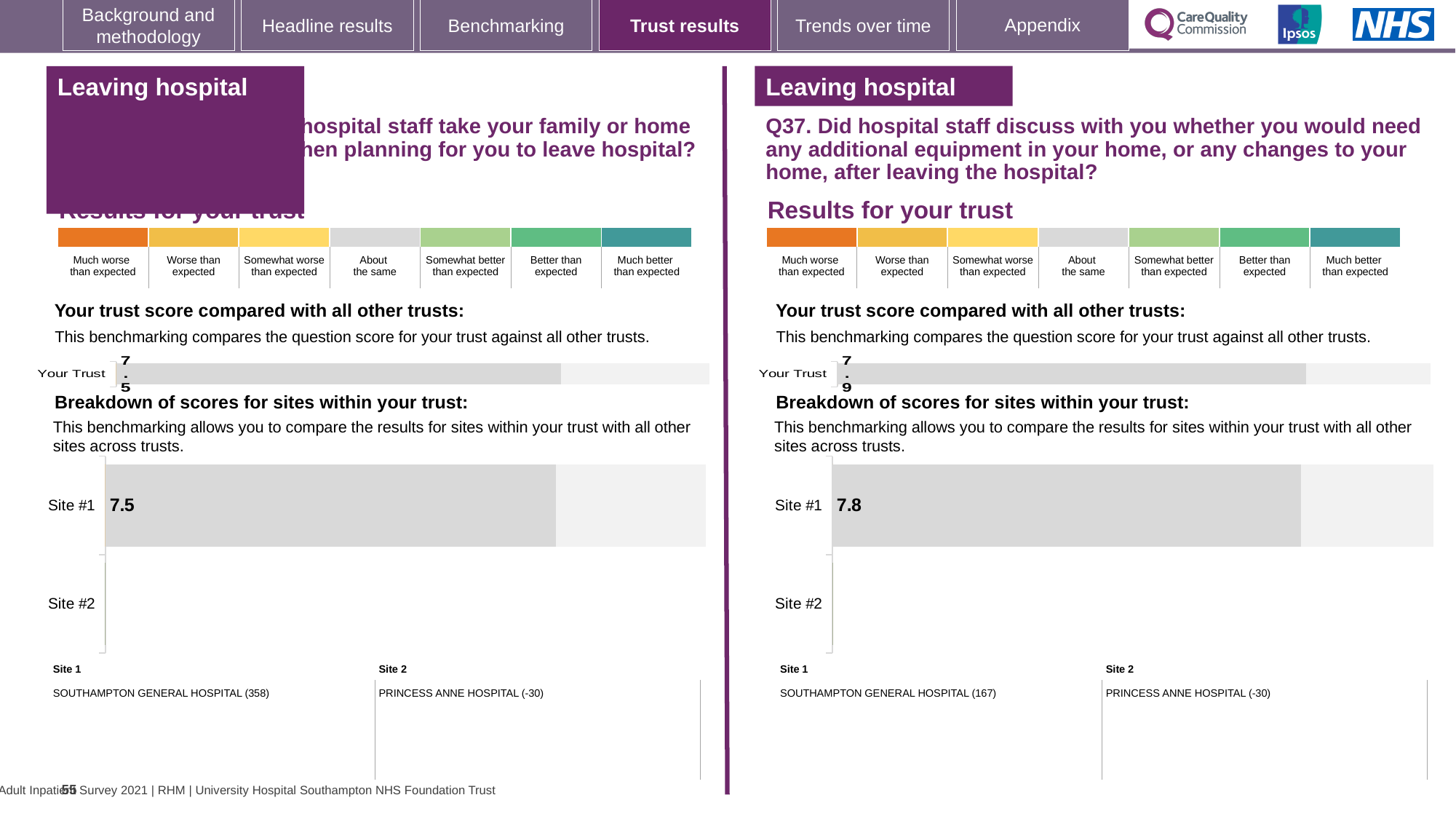
In the left-hand breakdown chart, is the Site #1 score greater or less than the Site #2 score, given Site #2 shows no bar? greater On the right-hand side of the slide (Q37), what is the score shown for Your Trust? 7.9 In the left-hand breakdown of scores for sites chart, what is the score for Site #1? 7.5 What type of chart is used to show the breakdown of scores for sites within your trust? Bar chart Which is larger: the Your Trust score on the left-hand side of the slide or the Your Trust score on the right-hand side (Q37)? Right-hand side (Q37) How many sites are listed in the left-hand breakdown of scores for sites chart? 2 What is the difference between the Site #1 score in the right-hand chart (Q37) and the Site #1 score in the left-hand chart? 0.3 What is the difference between the Your Trust score on the right-hand side (Q37) and the Your Trust score on the left-hand side? 0.4 Which hospital is listed as Site 1 on the slide? Southampton General Hospital In the right-hand breakdown of scores for sites chart (Q37), what is the score for Site #1? 7.8 On the left-hand side of the slide, what is the score shown for Your Trust? 7.5 In the right-hand breakdown of scores for sites chart (Q37), which site has a printed score? Site #1